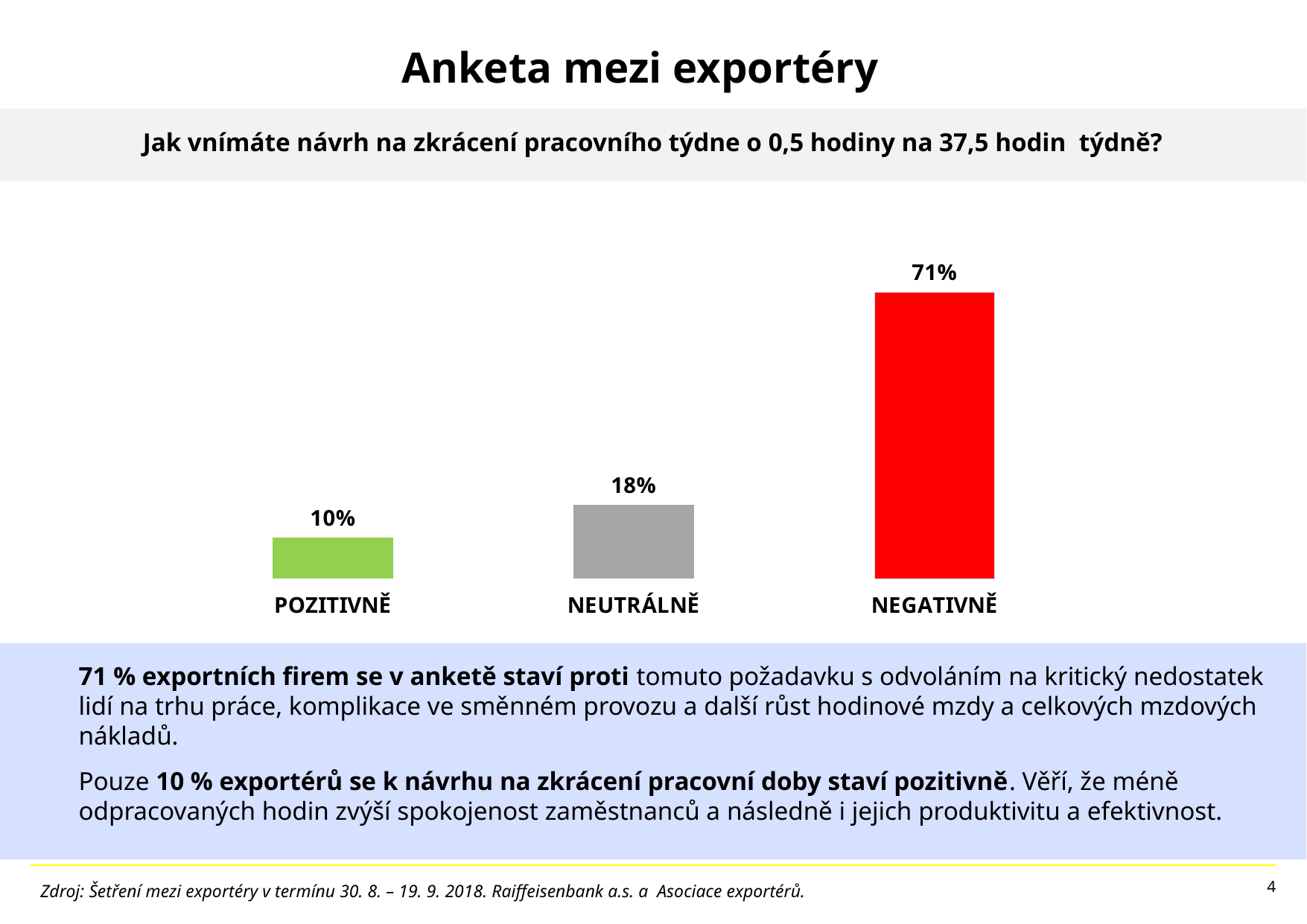
Do the values rise or fall from left to right across the categories? Rise What colour is the bar for NEGATIVNĚ? Red What is the value for POZITIVNĚ? 10% What is the value for NEGATIVNĚ? 71% Which category has the lowest value? POZITIVNĚ What is the value for NEUTRÁLNĚ? 18% What is the difference between the values for NEGATIVNĚ and NEUTRÁLNĚ? 53% How many categories are shown in the chart? 3 What is the difference between the values for NEUTRÁLNĚ and POZITIVNĚ? 8% Which category has the highest value? NEGATIVNĚ What kind of chart is shown on the slide? Bar chart Which is larger, the value for NEUTRÁLNĚ or the value for POZITIVNĚ? NEUTRÁLNĚ